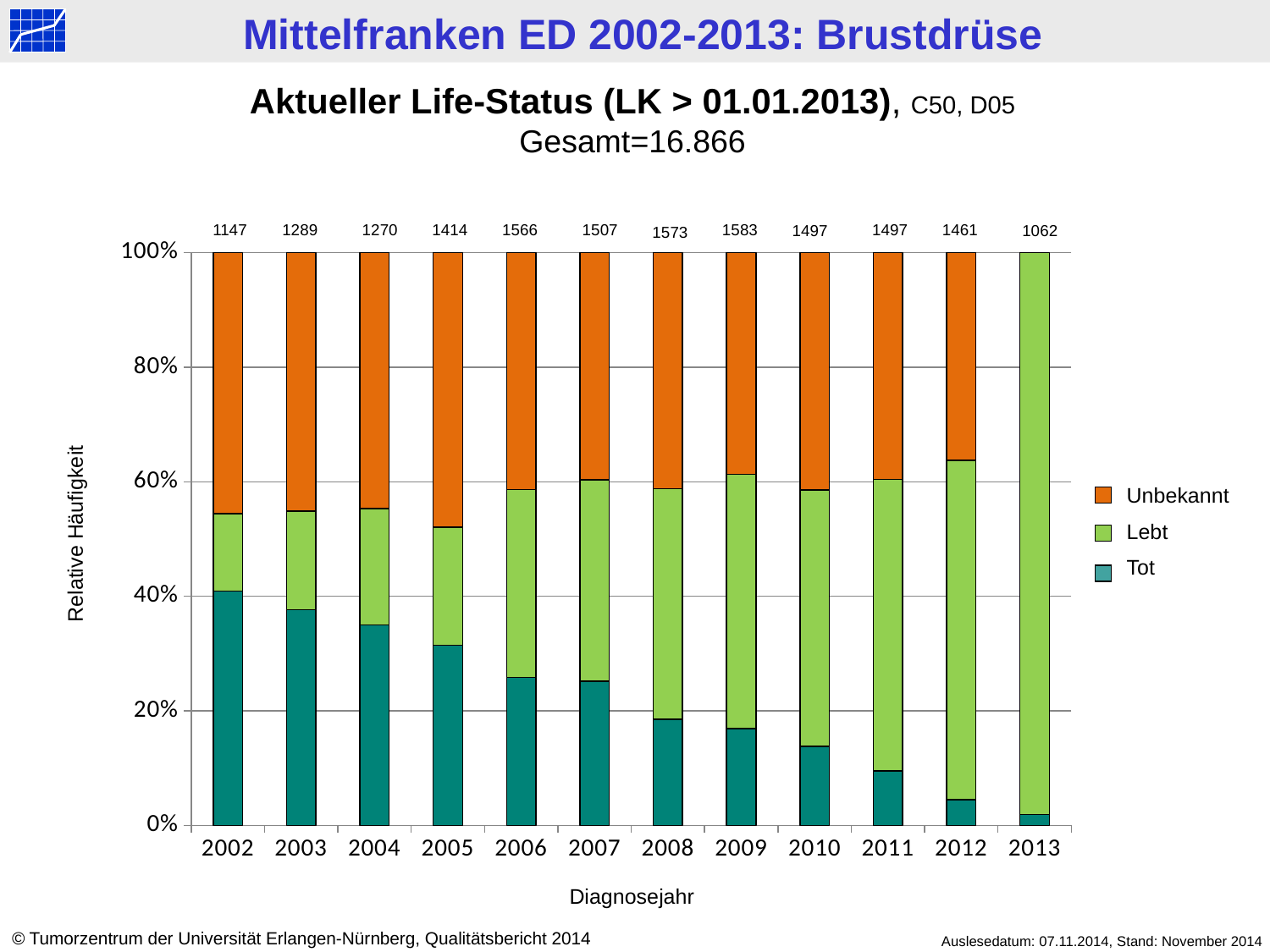
What number is printed above the bar for 2009? 1583 Which year has the larger number printed above its bar, 2006 or 2007? 2006 What number is printed above the bar for 2002? 1147 How many series does the legend list? 3 How many years are shown on the x axis? 12 Is the share of Tot in 2013 greater or less than 20%? less What is the difference between the numbers printed above the bars for 2005 and 2002? 267 Is the share of Tot in 2002 greater or less than 20%? greater Does the share of Tot rise or fall from 2002 to 2013? Fall Which year has the lowest number printed above its bar? 2013 Which year has the highest number printed above its bar? 2009 What kind of chart is shown on the slide? Stacked bar chart